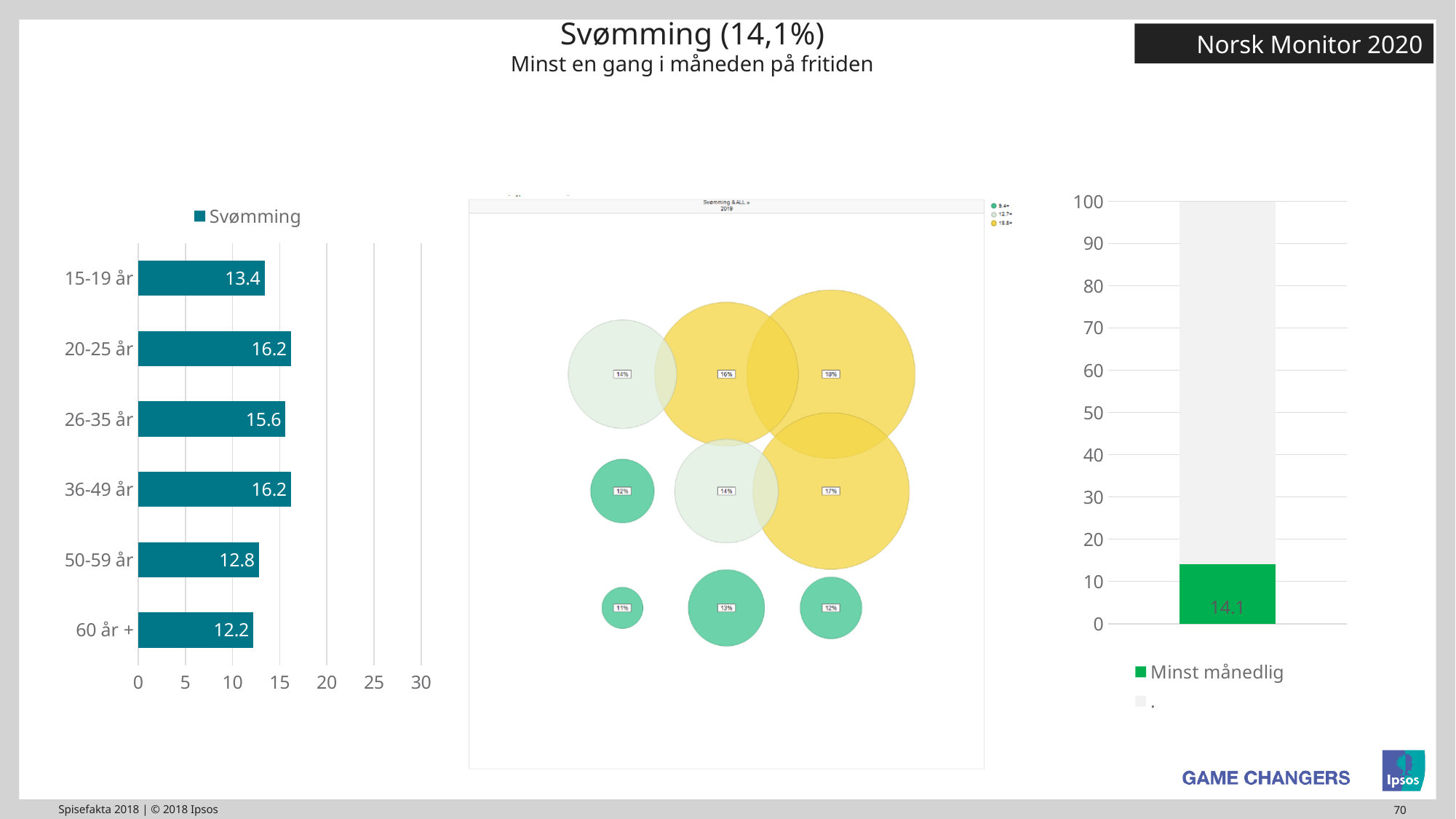
In the left bar chart, how many age groups are shown? 6 In the middle bubble chart, how many bubbles are plotted? 9 In the left bar chart, what is the value for 15-19 år? 13.4 What kind of chart is the left chart? Bar chart In the left bar chart, what is the value for 20-25 år? 16.2 In the right stacked bar chart, is the value for Minst månedlig greater or less than 20? less In the left bar chart, what is the value for 50-59 år? 12.8 In the left bar chart, what series name does the legend show? Svømming In the left bar chart, which age group has the lowest value? 60 år + In the left bar chart, what is the difference between the values for 26-35 år and 60 år +? 3.4 In the left bar chart, which is larger: the value for 26-35 år or the value for 50-59 år? 26-35 år In the right stacked bar chart, what is the value for Minst månedlig? 14.1